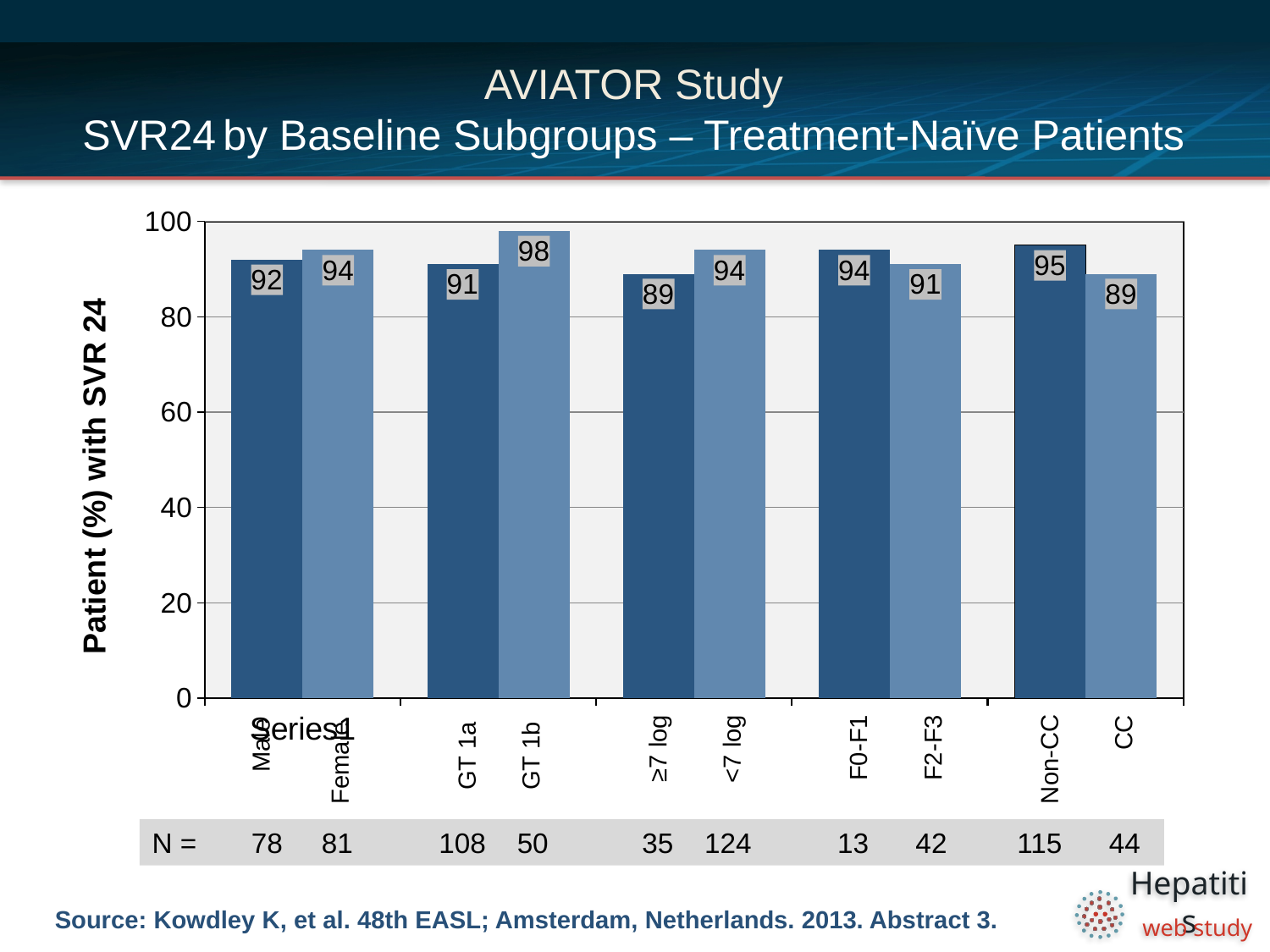
What kind of chart is shown on the slide? bar chart What is the value for Female? 94 What is the value for GT 1b? 98 Is the value for F2-F3 greater or less than 80? greater What is the difference between the values for GT 1b and GT 1a? 7 What is the value for Non-CC? 95 What is the difference between the values for F0-F1 and F2-F3? 3 Which is larger, the value for ≥7 log or the value for <7 log? <7 log Which category has the highest value? GT 1b Which is larger, the value for Non-CC or the value for CC? Non-CC What is the label of the vertical axis? Patient (%) with SVR 24 What is the value for ≥7 log? 89